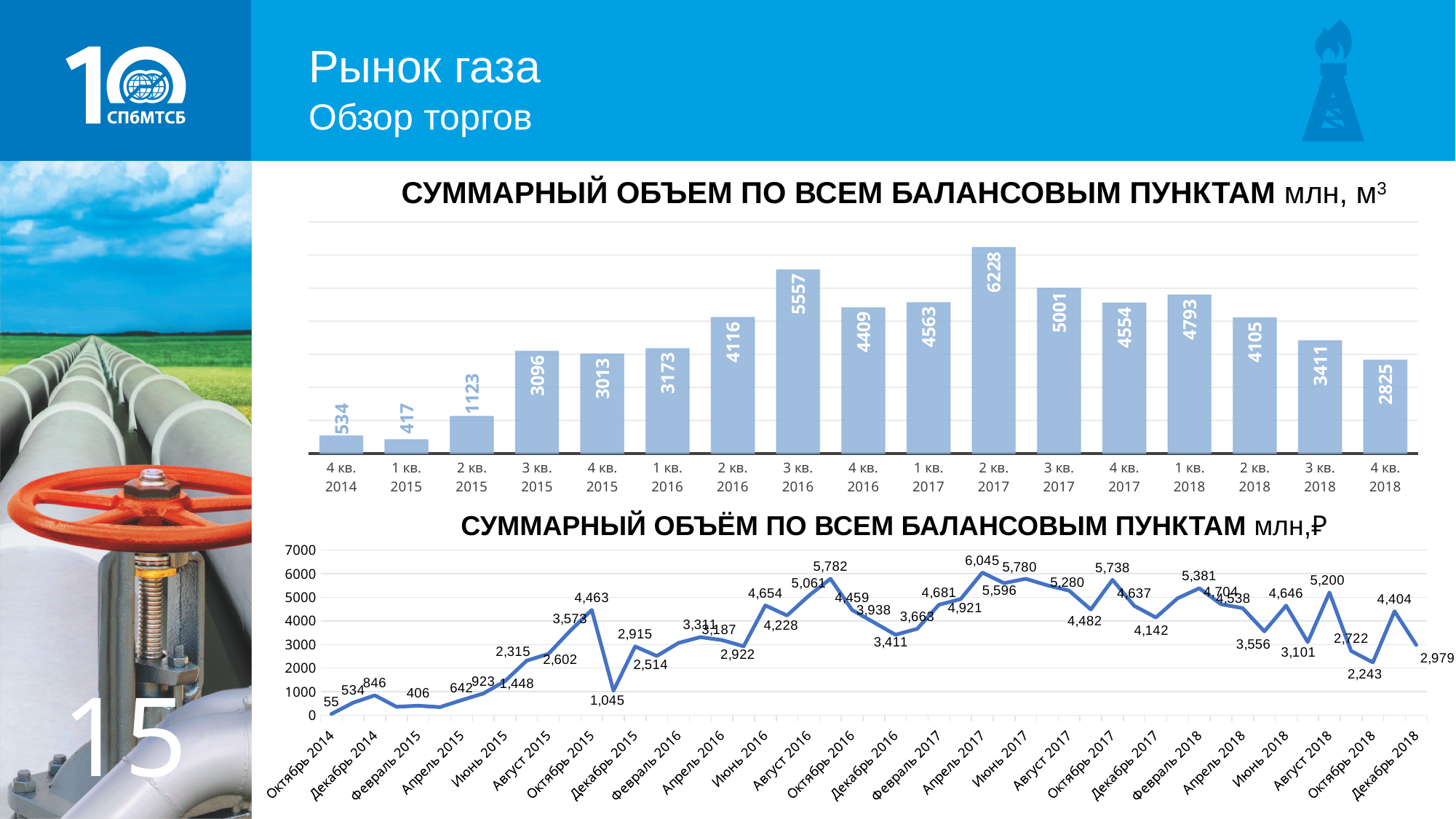
What type of chart is the top chart on the slide? bar chart In the top bar chart, which is larger: 1 кв. 2018 or 4 кв. 2017? 1 кв. 2018 In the top bar chart (СУММАРНЫЙ ОБЪЕМ ПО ВСЕМ БАЛАНСОВЫМ ПУНКТАМ млн, м3), what is the value for 2 кв. 2017? 6228 In the bottom line chart (СУММАРНЫЙ ОБЪЁМ ПО ВСЕМ БАЛАНСОВЫМ ПУНКТАМ млн, ₽), what is the highest value labelled? 6,045 In the bottom line chart, what is the value for Декабрь 2018? 2,979 In the top bar chart, which quarter has the lowest value? 1 кв. 2015 In the top bar chart, do the values rise or fall from 1 кв. 2018 to 4 кв. 2018? fall How many bars are shown in the top bar chart? 17 In the top bar chart, which quarter has the highest value? 2 кв. 2017 In the top bar chart, what is the value for 4 кв. 2018? 2825 In the bottom line chart, what is the value for Октябрь 2014? 55 In the top bar chart, what is the difference between 3 кв. 2016 and 4 кв. 2016? 1148